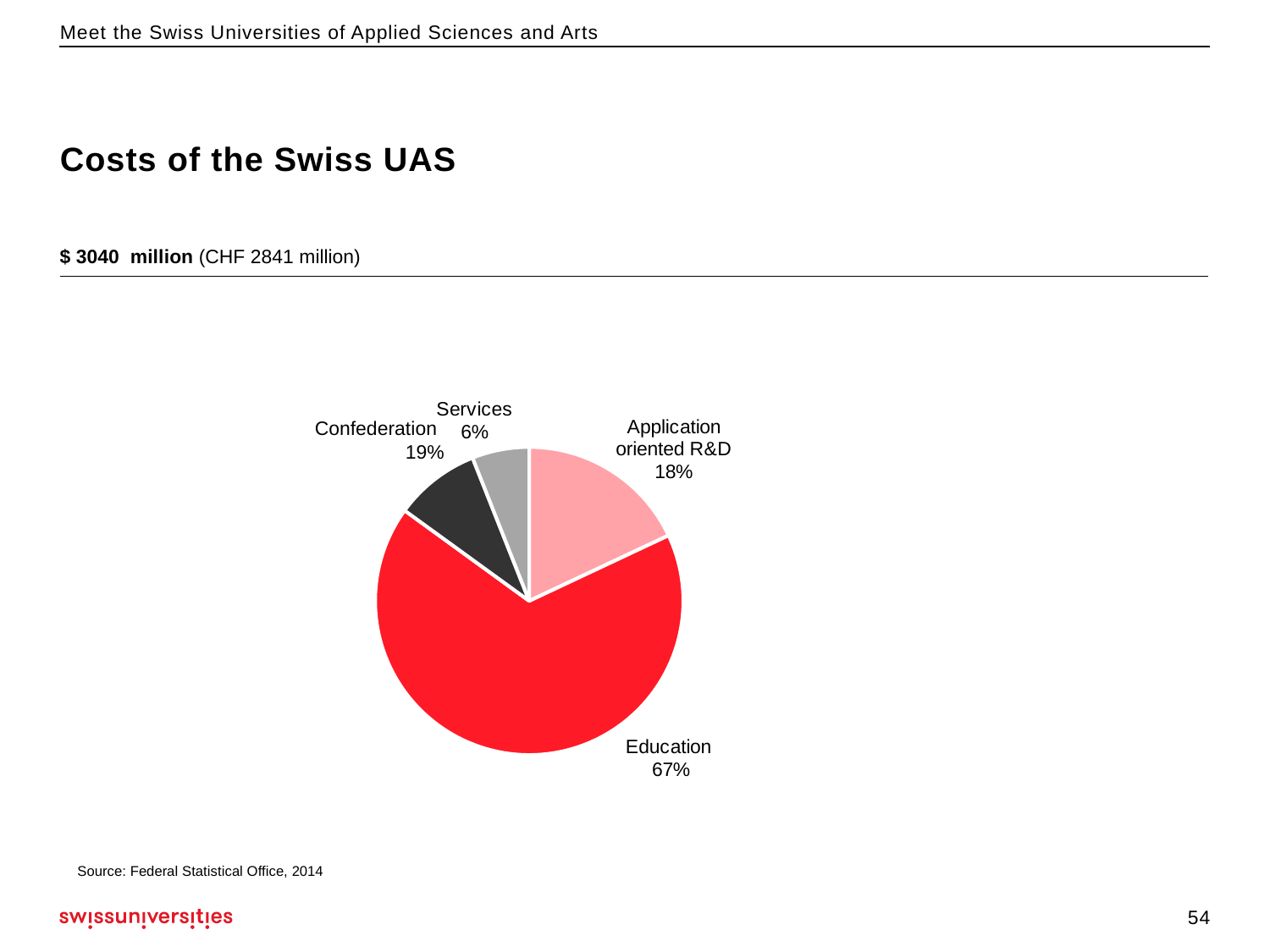
How many slices does the pie chart have? 4 What percentage is shown for Services? 6% Which slice of the pie is the largest? Education Which is larger, the share for Education or the share for Application oriented R&D? Education What kind of chart is shown on the slide? pie chart What is the difference in percentage points between Confederation and Services? 13 Which slice of the pie is the smallest? Services What percentage is shown for Application oriented R&D? 18% What is the difference in percentage points between Education and Confederation? 48 What percentage is shown for Confederation? 19% What is the title of the slide containing the pie chart? Costs of the Swiss UAS What share of the pie does Education account for? 67%